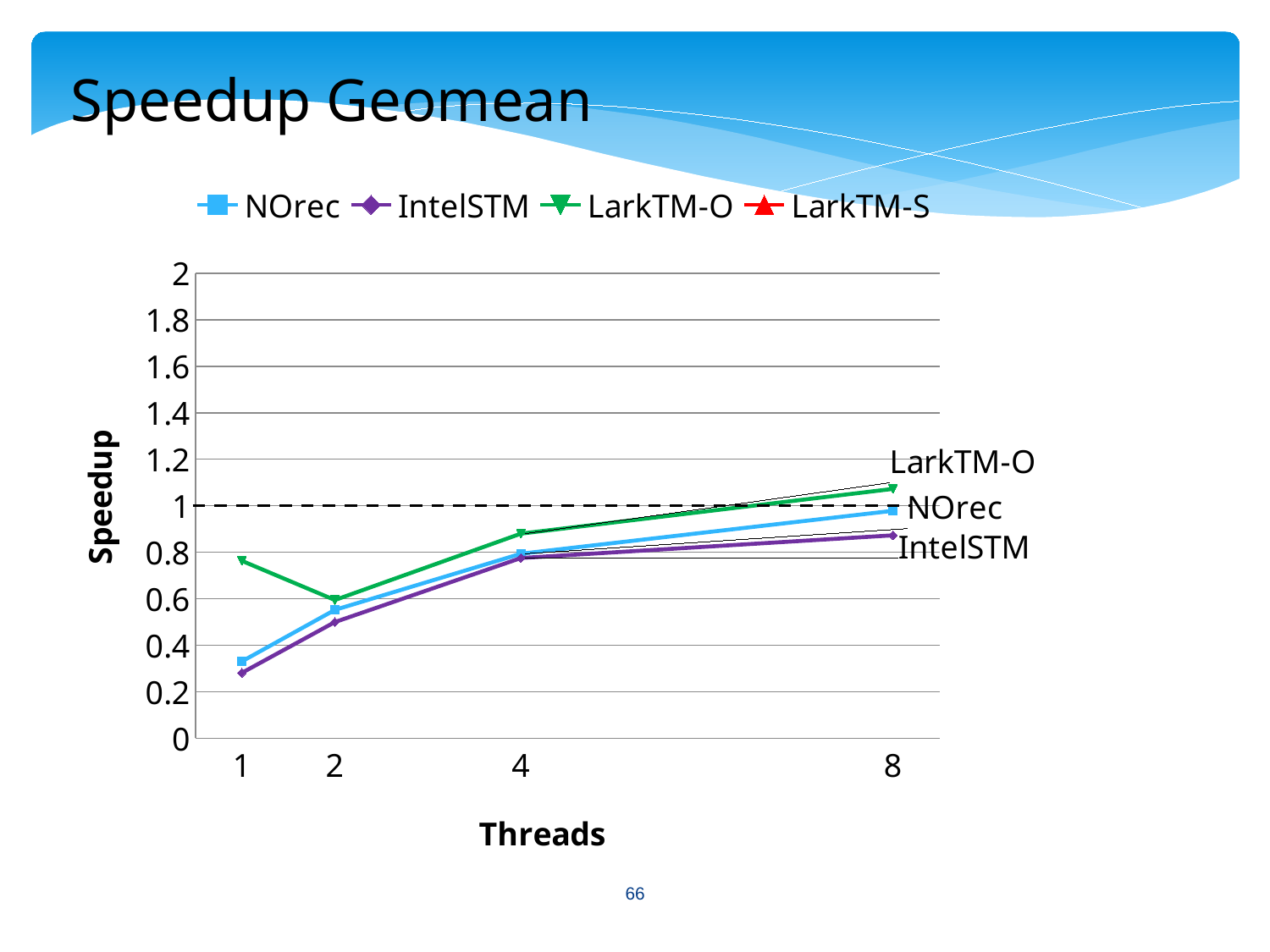
Which series has the lowest speedup at 1 thread? IntelSTM Is the NOrec speedup at 1 thread greater or less than 0.4? less Is the IntelSTM speedup at 8 threads greater or less than 1? less What is the title of the x axis? Threads Does the LarkTM-O speedup rise or fall from 1 thread to 2 threads? falls How many thread counts are shown on the x axis? 4 Is the LarkTM-O speedup at 8 threads greater or less than 1? greater What kind of chart is shown on the slide? line chart Which series has the highest speedup at 8 threads? LarkTM-O How many series does the legend list? 4 At 1 thread, which has the larger speedup, LarkTM-O or NOrec? LarkTM-O Does the NOrec speedup rise or fall as the number of threads increases? rises